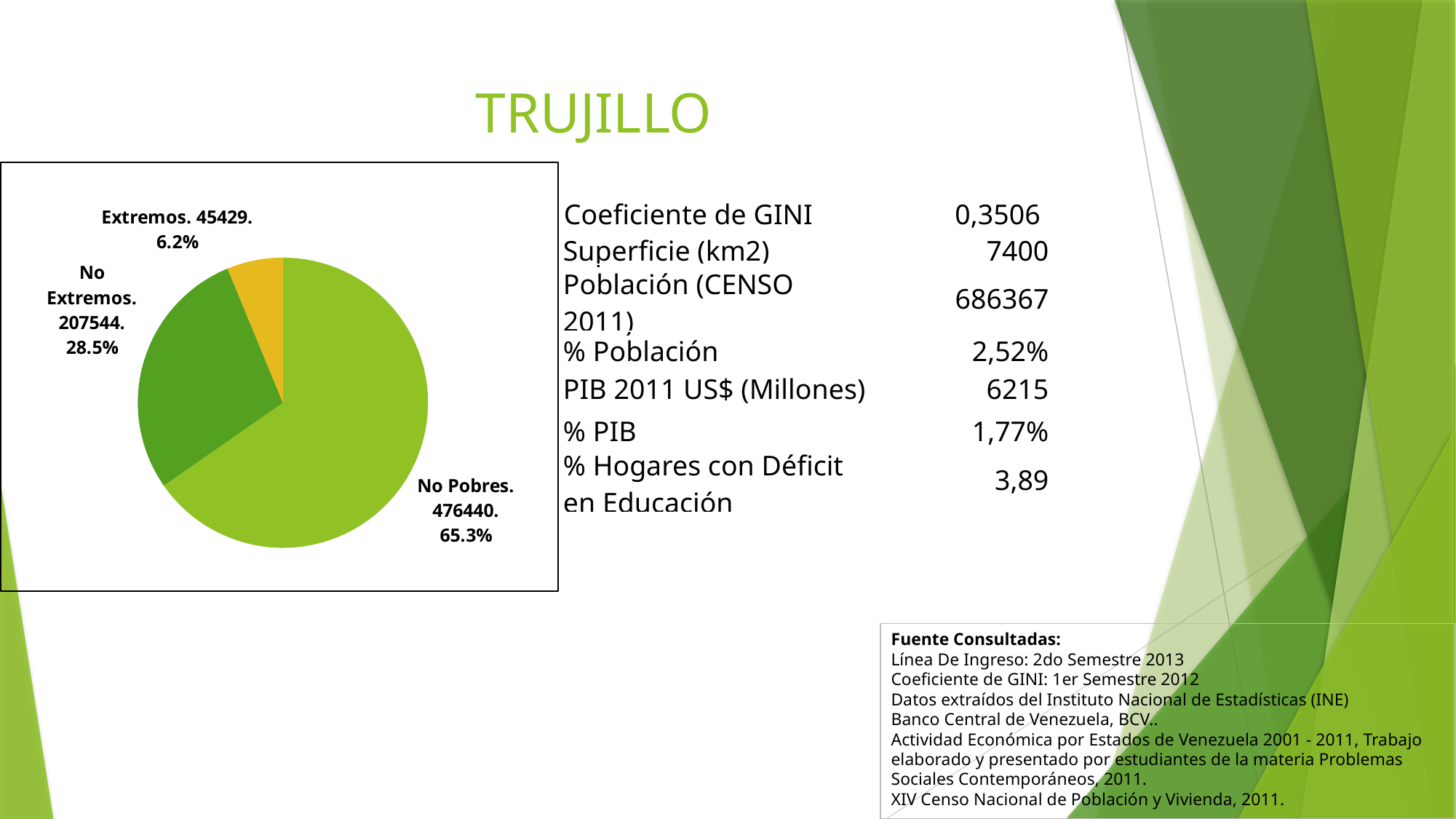
Which slice of the pie chart is the smallest? Extremos Which slice of the pie chart is the largest? No Pobres What is the value for No Extremos in the pie chart? 207544 Which is larger, the No Extremos value or the Extremos value? No Extremos What share of the pie does the No Pobres slice represent? 65.3% What is the difference between the No Pobres value and the No Extremos value? 268896 What is the value for No Pobres in the pie chart? 476440 What share of the pie does the Extremos slice represent? 6.2% How many slices does the pie chart have? 3 What is the value for Extremos in the pie chart? 45429 What kind of chart is shown on the slide? pie chart What colour is the Extremos slice in the pie chart? yellow